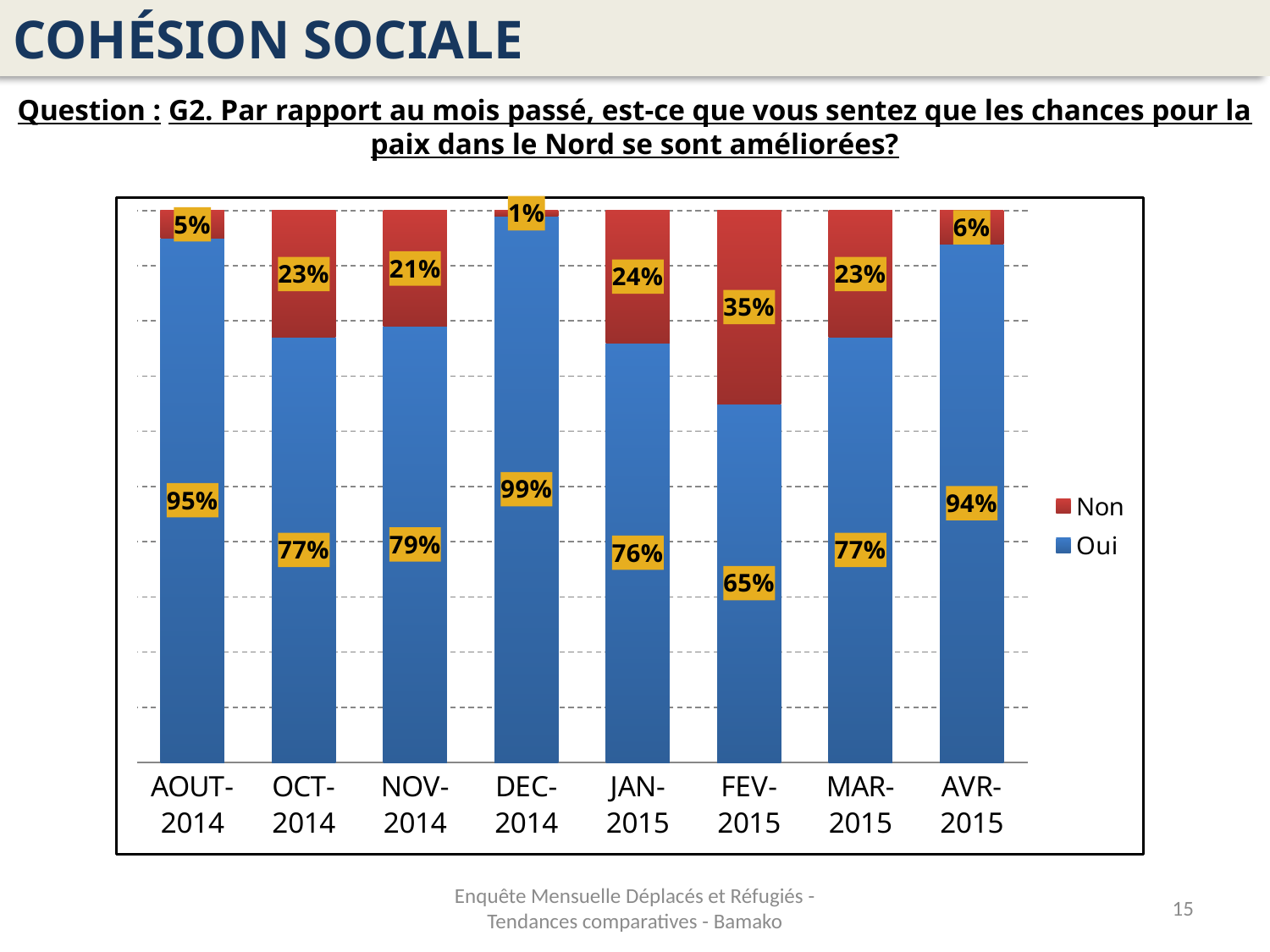
Which is larger, the Oui value for NOV-2014 or the Oui value for JAN-2015? NOV-2014 What is the total of the stacked bar for MAR-2015? 100% What kind of chart is shown on the slide? Stacked bar chart How many months are shown on the x axis? 8 Which month has the lowest value for Oui? FEV-2015 What is the difference between the Oui values for AOUT-2014 and OCT-2014? 18% What is the value for Oui in FEV-2015? 65% What is the value for Non in OCT-2014? 23% Which month has the highest value for Non? FEV-2015 What is the value for Oui in DEC-2014? 99% What is the value for Non in AVR-2015? 6% How many series does the legend list? 2